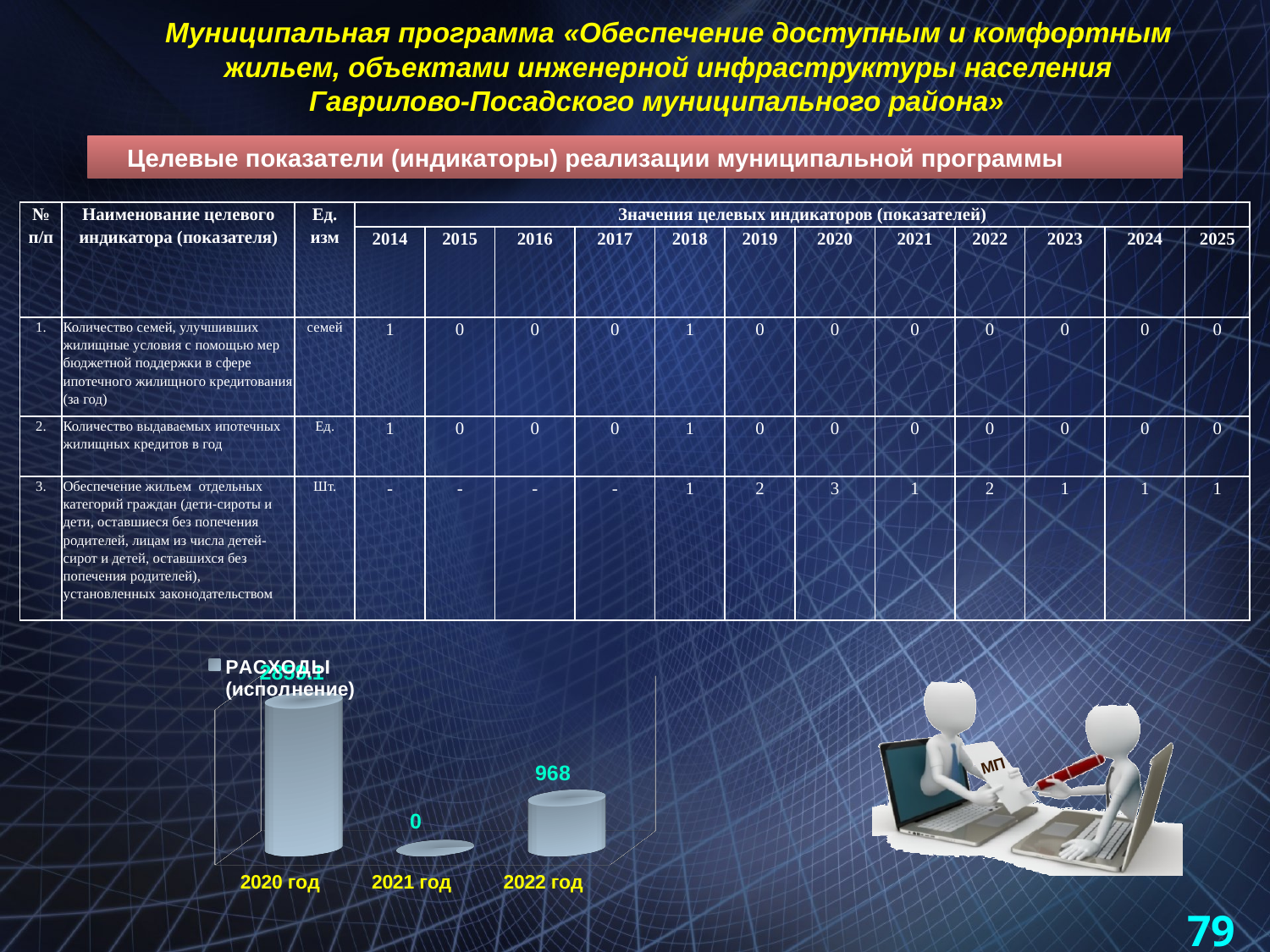
Does the value in the bar chart at the bottom left rise or fall from 2021 год to 2022 год? Rise What kind of chart is shown at the bottom left of the slide? Bar chart In the bar chart at the bottom left, which is larger: the value for 2020 год or the value for 2022 год? 2020 год What is the value for 2021 год in the bar chart at the bottom left? 0 Which year has the lowest value in the bar chart at the bottom left? 2021 год What is the name of the series in the legend of the bar chart at the bottom left? РАСХОДЫ (исполнение) What is the value for 2022 год in the bar chart at the bottom left? 968 What is the difference between the values for 2022 год and 2021 год in the bar chart at the bottom left? 968 Which year has the highest value in the bar chart at the bottom left? 2020 год How many years (categories) are shown in the bar chart at the bottom left? 3 How many series does the legend of the bar chart at the bottom left list? 1 In the bar chart at the bottom left, which is larger: the value for 2022 год or the value for 2021 год? 2022 год